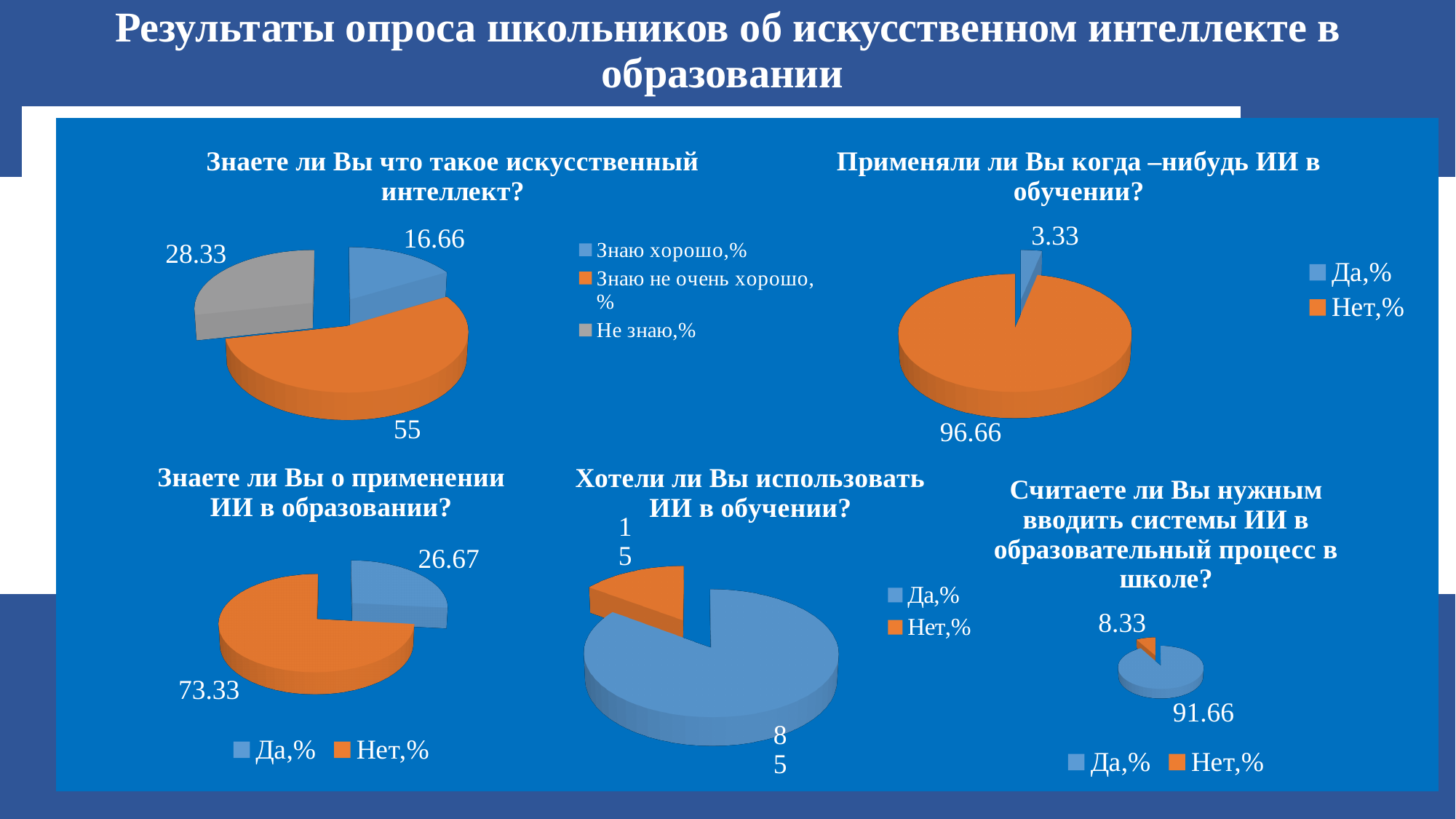
In the chart "Знаете ли Вы что такое искусственный интеллект?", which category has the smallest slice? Знаю хорошо,% In the chart "Знаете ли Вы о применении ИИ в образовании?", what is the value for "Нет,%"? 73.33 In the chart "Считаете ли Вы нужным вводить системы ИИ в образовательный процесс в школе?", which category has the largest slice? Да,% In the chart "Считаете ли Вы нужным вводить системы ИИ в образовательный процесс в школе?", what is the value for "Нет,%"? 8.33 In the chart "Применяли ли Вы когда –нибудь ИИ в обучении?", what is the value for "Да,%"? 3.33 What type of chart is used for "Применяли ли Вы когда –нибудь ИИ в обучении?"? Pie chart How many categories does the legend of the chart "Знаете ли Вы что такое искусственный интеллект?" list? 3 In the chart "Хотели ли Вы использовать ИИ в обучении?", what is the value for "Да,%"? 85 In the chart "Применяли ли Вы когда –нибудь ИИ в обучении?", what is the difference between the "Нет,%" and "Да,%" values? 93.33 In the chart "Знаете ли Вы что такое искусственный интеллект?", what is the value for "Знаю не очень хорошо,%"? 55 In the chart "Знаете ли Вы что такое искусственный интеллект?", what is the value for "Не знаю,%"? 28.33 In the chart "Знаете ли Вы о применении ИИ в образовании?", which is larger, "Да,%" or "Нет,%"? Нет,%